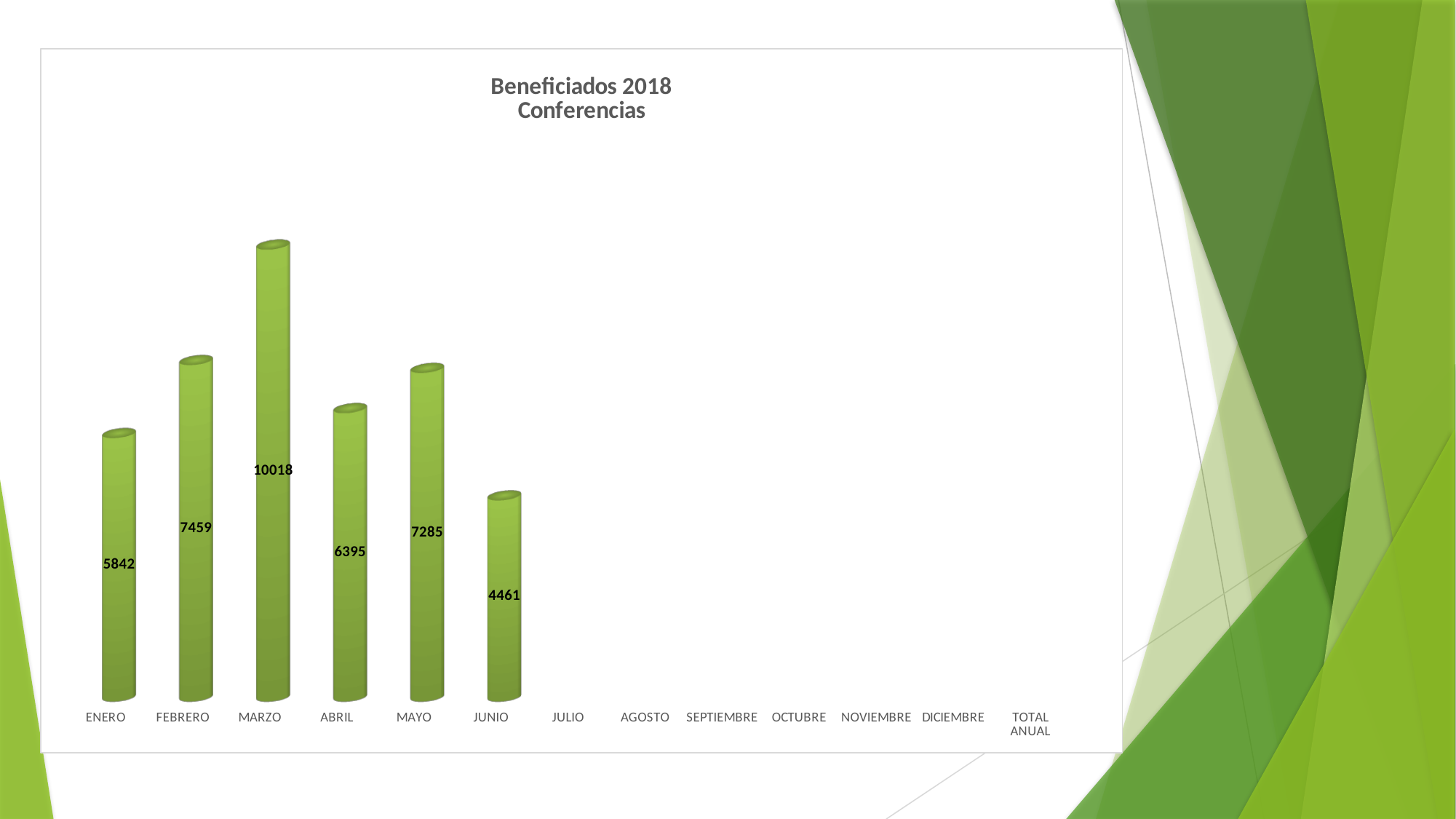
What is the value for ENERO? 5842 Which month with a plotted bar has the lowest value? JUNIO Which is larger, the value for FEBRERO or the value for MAYO? FEBRERO What is the title of the chart? Beneficiados 2018 Conferencias What is the value for JUNIO? 4461 What is the difference between the values for MARZO and JUNIO? 5557 What kind of chart is this? bar chart What is the value for MARZO? 10018 How many months have a bar plotted on the chart? 6 What is the difference between the values for FEBRERO and ABRIL? 1064 Which month has the highest value? MARZO How many category labels are shown on the x axis? 13